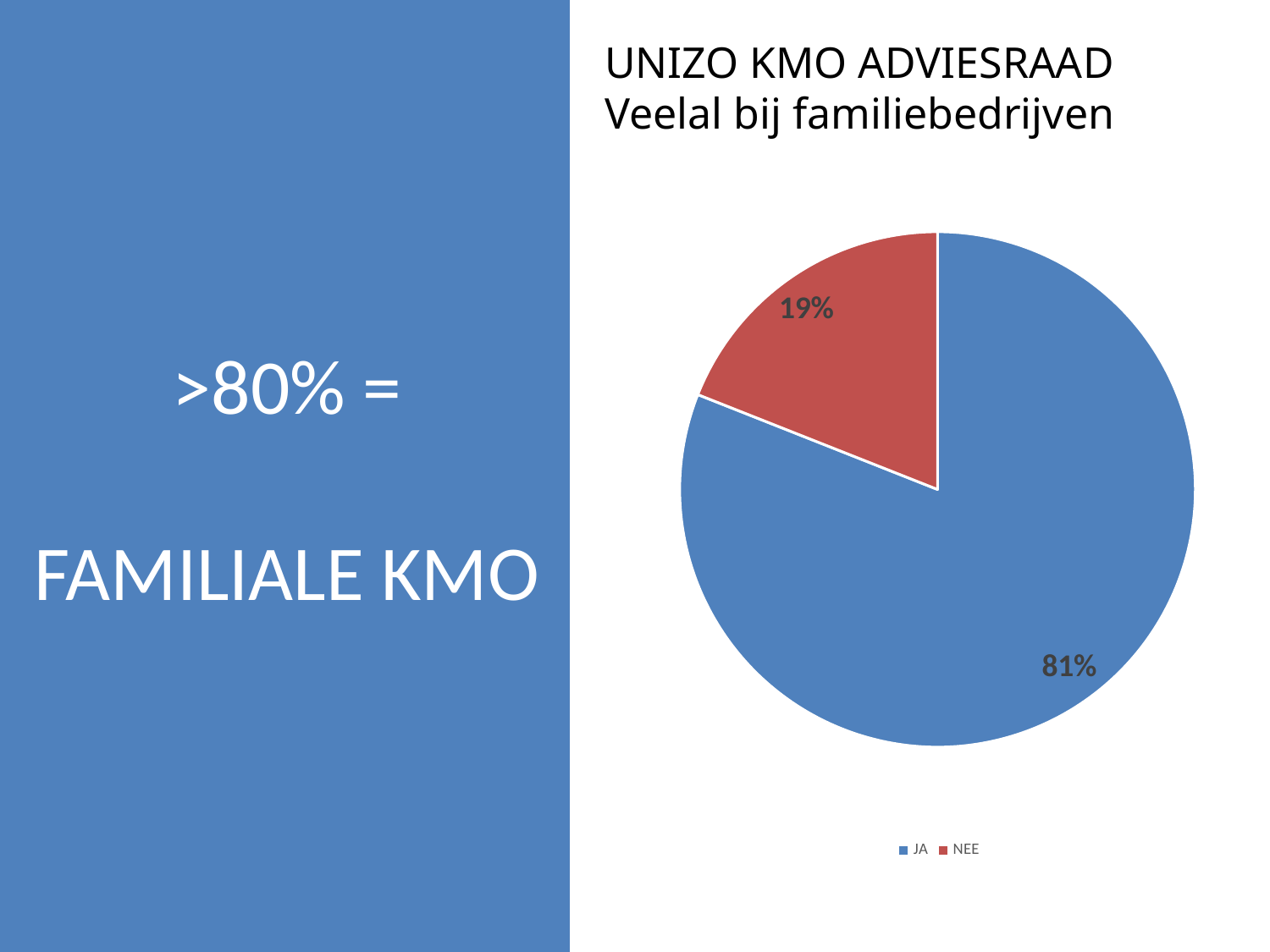
What colour is the JA slice in the pie chart? blue What share of the pie does the NEE slice represent? 19% What colour is the NEE slice in the pie chart? red What kind of chart is shown on the slide? pie chart What is the difference in percentage points between the JA and NEE slices? 62 Which slice is larger, JA or NEE? JA Which slice of the pie is the smallest? NEE How many slices does the pie chart have? 2 How many entries does the legend list? 2 What share of the pie does the JA slice represent? 81% Which slice of the pie is the largest? JA